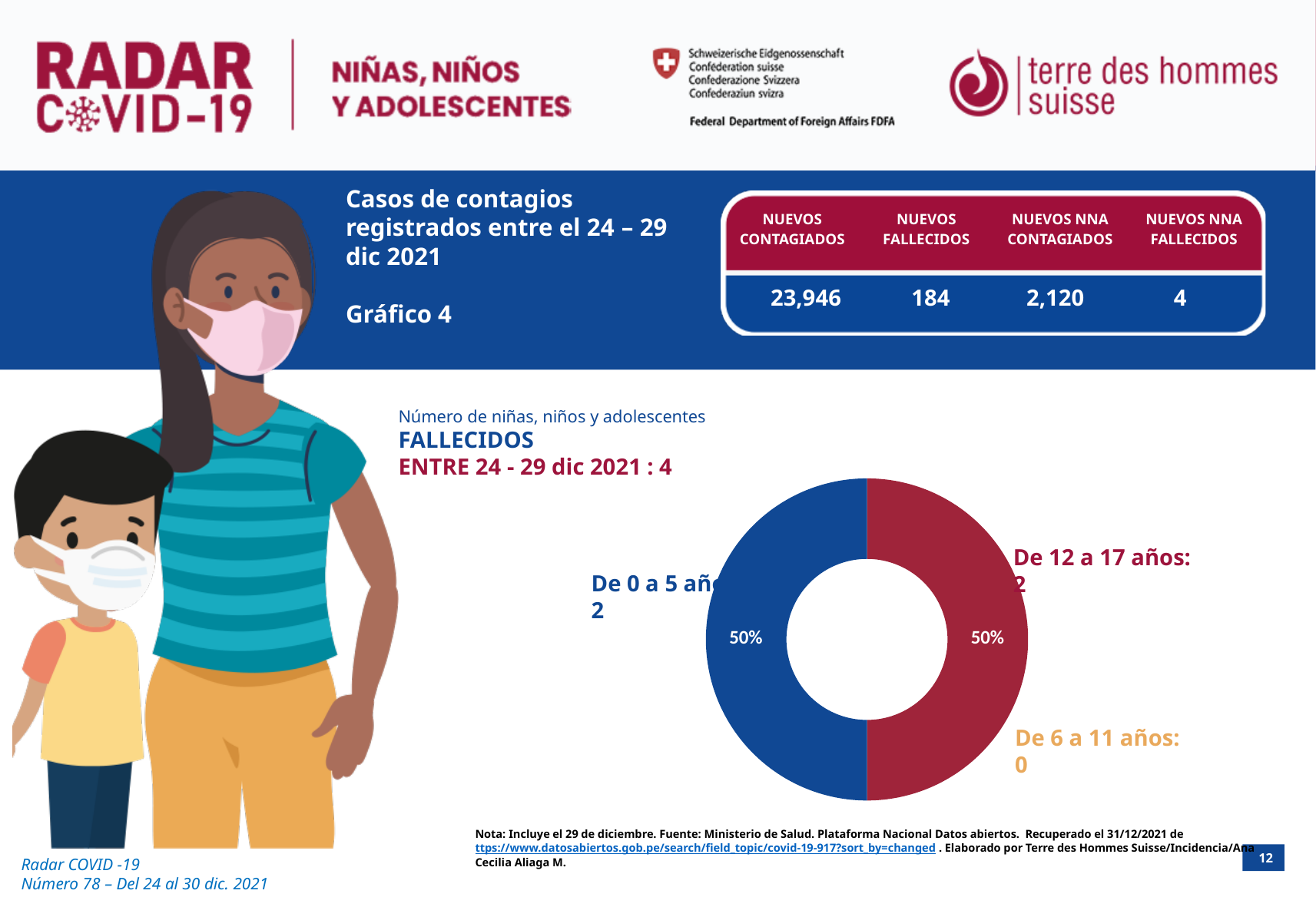
How many deaths are shown for the 'De 6 a 11 años' category? 0 What share of the donut chart does the 'De 12 a 17 años' slice represent? 50% What colour is the 'De 0 a 5 años' slice of the donut chart? Blue Is the value for 'De 0 a 5 años' larger than the value for 'De 6 a 11 años'? Yes How many deaths are shown for the 'De 0 a 5 años' category? 2 Which age category has the lowest number of deaths in the chart? De 6 a 11 años What is the difference between the deaths for 'De 0 a 5 años' and 'De 6 a 11 años'? 2 How many deaths are shown for the 'De 12 a 17 años' category? 2 What share of the donut chart does the 'De 0 a 5 años' slice represent? 50% What kind of chart is shown on the slide? Donut chart What is the total number of children and adolescents who died between 24 and 29 December 2021, according to the chart heading? 4 How many age categories are labelled on the chart? 3